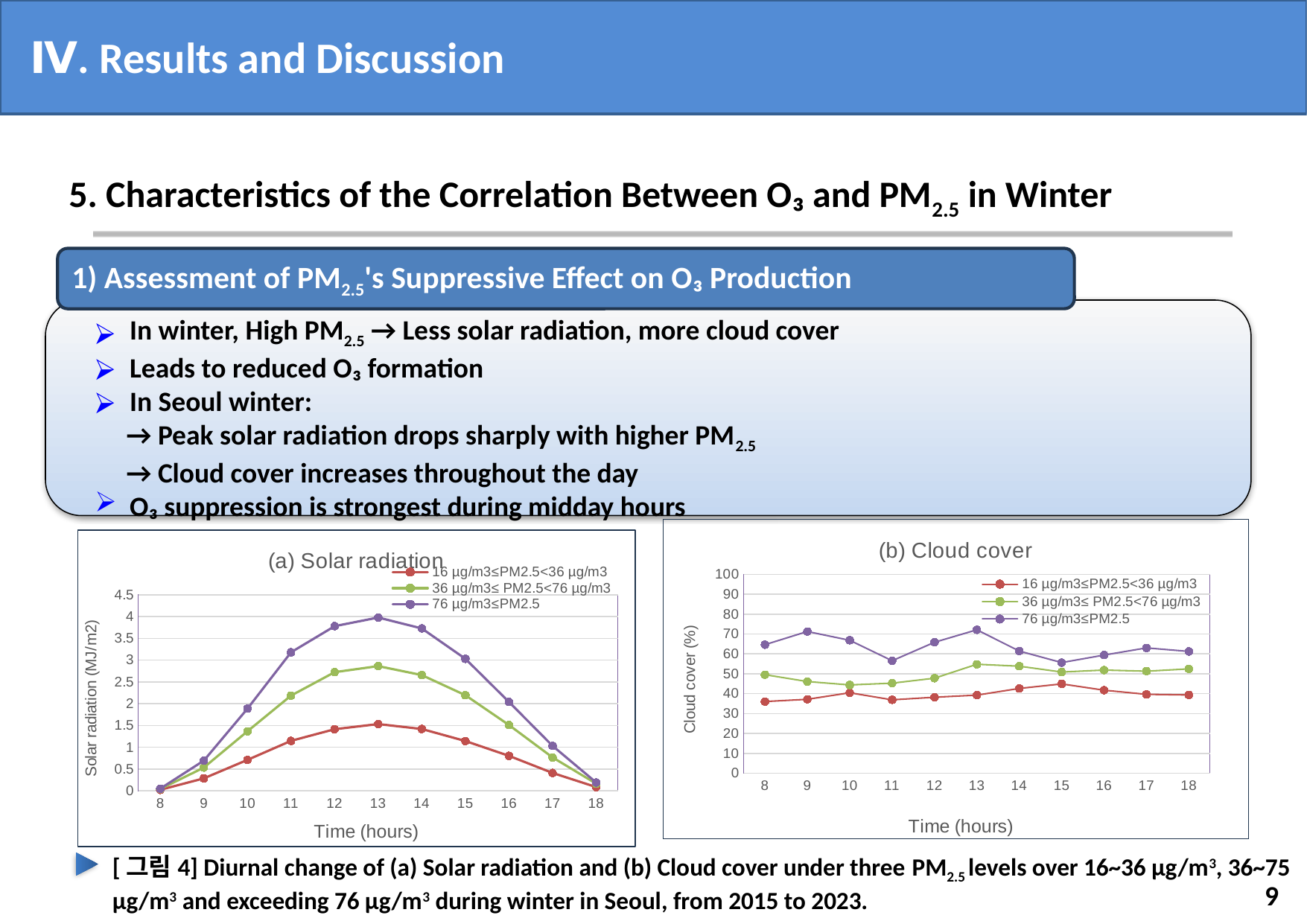
In the (a) Solar radiation chart, is the value for the 16 µg/m3≤PM2.5<36 µg/m3 series at 13 hours greater or less than 2? less In the (a) Solar radiation chart, does the 76 µg/m3≤PM2.5 series rise or fall from 13 hours to 18 hours? fall In the (b) Cloud cover chart, is the value for the 16 µg/m3≤PM2.5<36 µg/m3 series at 8 hours greater or less than 40? less How many time points are plotted along the x axis of the (a) Solar radiation chart? 11 In the (a) Solar radiation chart, which series has the highest value at 13 hours? 76 µg/m3≤PM2.5 What kind of chart is the (a) Solar radiation chart? line chart In the (b) Cloud cover chart, is the value for the 76 µg/m3≤PM2.5 series at 13 hours greater or less than 60? greater What is the y-axis label of the (b) Cloud cover chart? Cloud cover (%) In the (b) Cloud cover chart, which series is larger at 13 hours: 76 µg/m3≤PM2.5 or 36 µg/m3≤ PM2.5<76 µg/m3? 76 µg/m3≤PM2.5 How many series does the legend of the (b) Cloud cover chart list? 3 In the (a) Solar radiation chart, which series has the lowest value at 13 hours? 16 µg/m3≤PM2.5<36 µg/m3